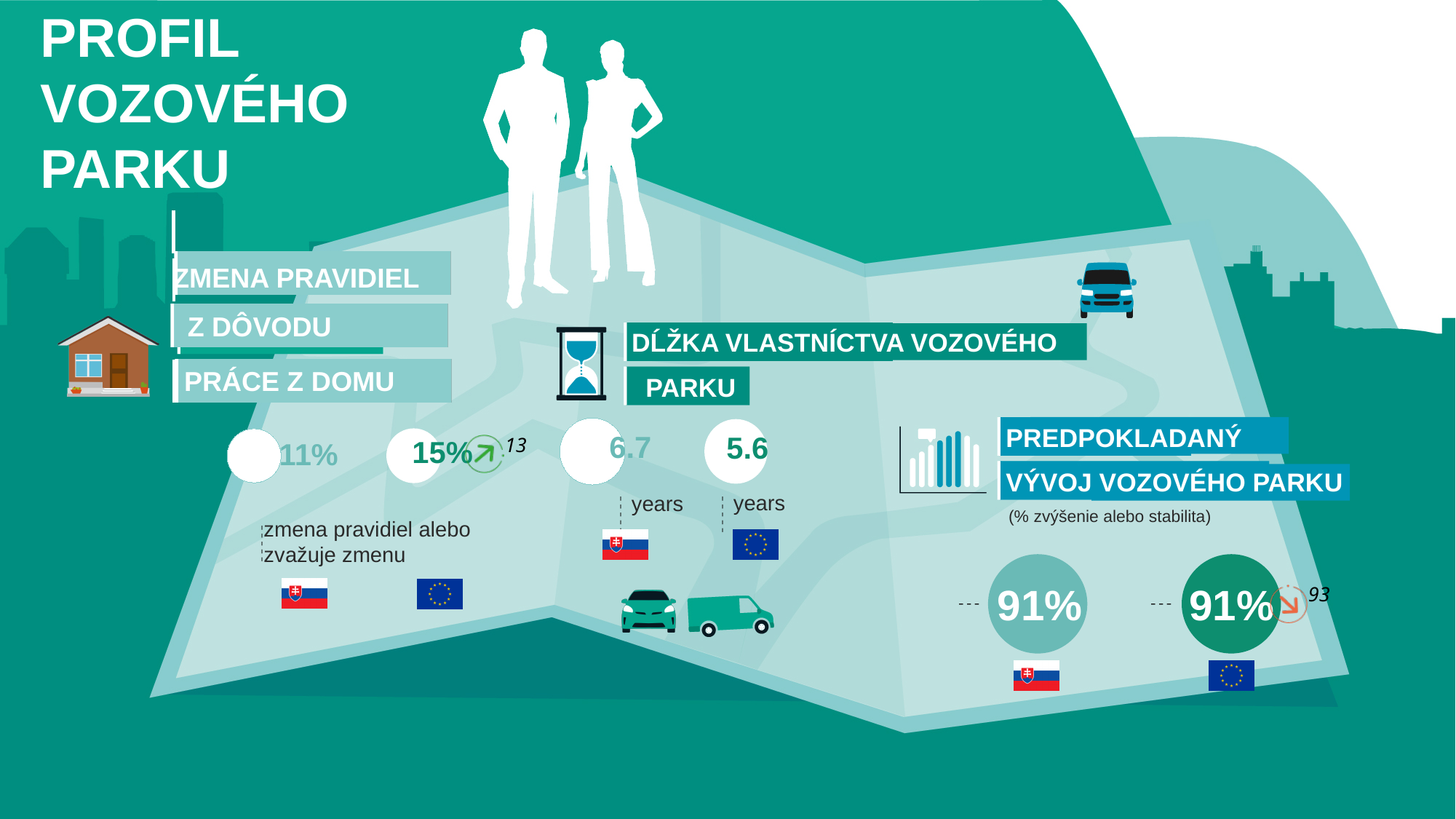
In the 'Predpokladaný vývoj vozového parku' section, what is the value shown for Slovakia? 91% In the 'Zmena pravidiel z dôvodu práce z domu' section, what is the value shown next to the EU flag? 15% In the 'Zmena pravidiel z dôvodu práce z domu' section, what is the difference between the EU value and the Slovak value? 4 percentage points How many data sections with values are shown on the slide? 3 In the 'Zmena pravidiel z dôvodu práce z domu' section, which is larger, the Slovak value or the EU value? EU value In the 'Predpokladaný vývoj vozového parku' section, what is the value shown for the EU? 91% In the 'Dĺžka vlastníctva vozového parku' section, how many years is shown for the EU? 5.6 years In the 'Dĺžka vlastníctva vozového parku' section, what is the difference in years between Slovakia and the EU? 1.1 years In the 'Zmena pravidiel z dôvodu práce z domu' section, what is the value shown next to the Slovak flag? 11% In the 'Dĺžka vlastníctva vozového parku' section, which has the longer ownership length, Slovakia or the EU? Slovakia In the 'Dĺžka vlastníctva vozového parku' section, how many years is shown for Slovakia? 6.7 years What is the main title of the slide? PROFIL VOZOVÉHO PARKU